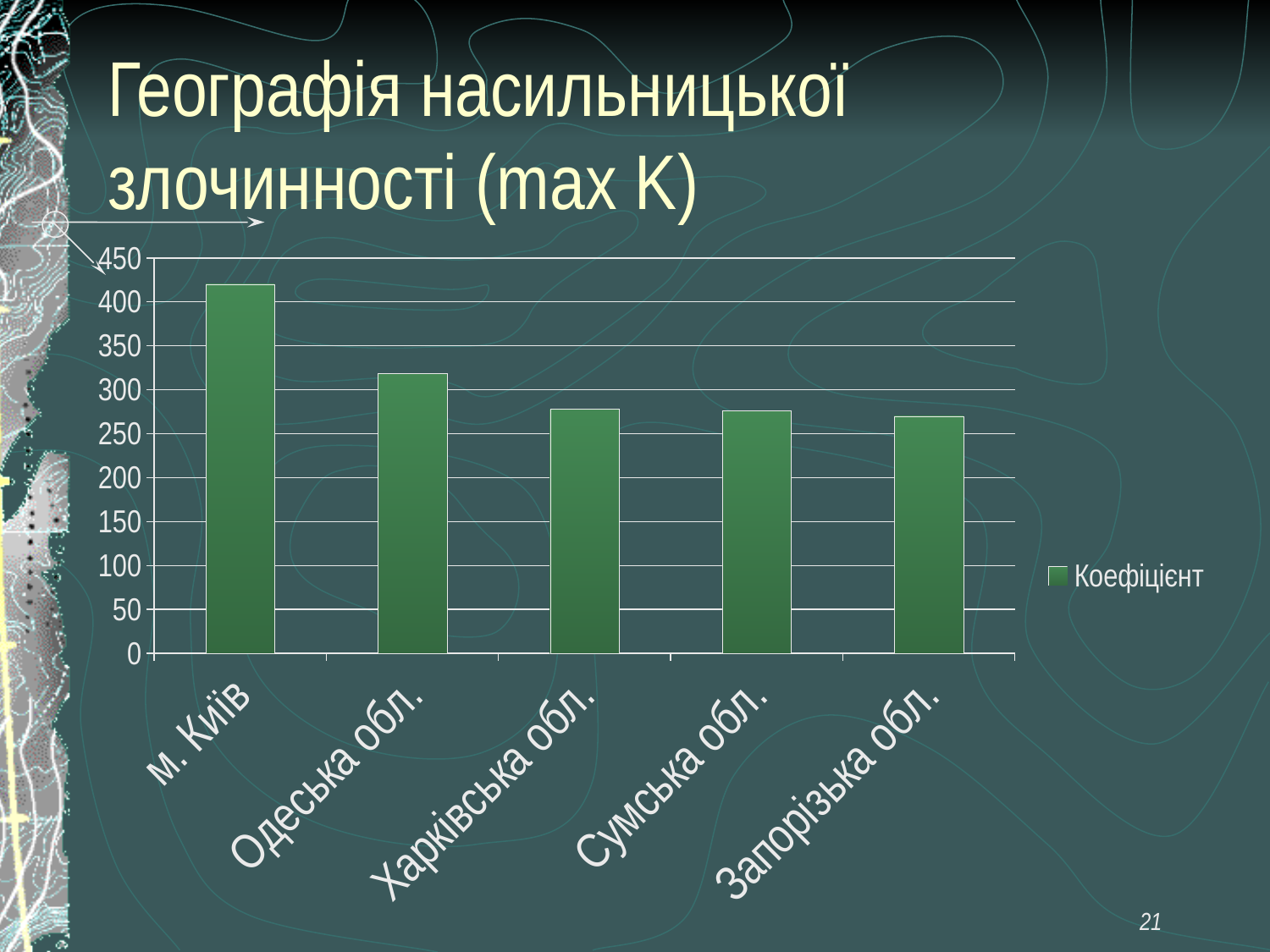
Is the value for м. Київ greater or less than 400? greater Do the values rise or fall moving from left to right along the x axis? fall What is the name of the series shown in the chart's legend? Коефіцієнт Is the value for Сумська обл. greater or less than 300? less Which category has the highest value in the chart? м. Київ Is the value for Запорізька обл. greater or less than 250? greater Which is larger, the value for м. Київ or the value for Одеська обл.? м. Київ What kind of chart is shown on the slide? bar chart How many categories (regions) are shown on the x axis of the chart? 5 Which is larger, the value for Одеська обл. or the value for Харківська обл.? Одеська обл. How many series does the chart's legend list? 1